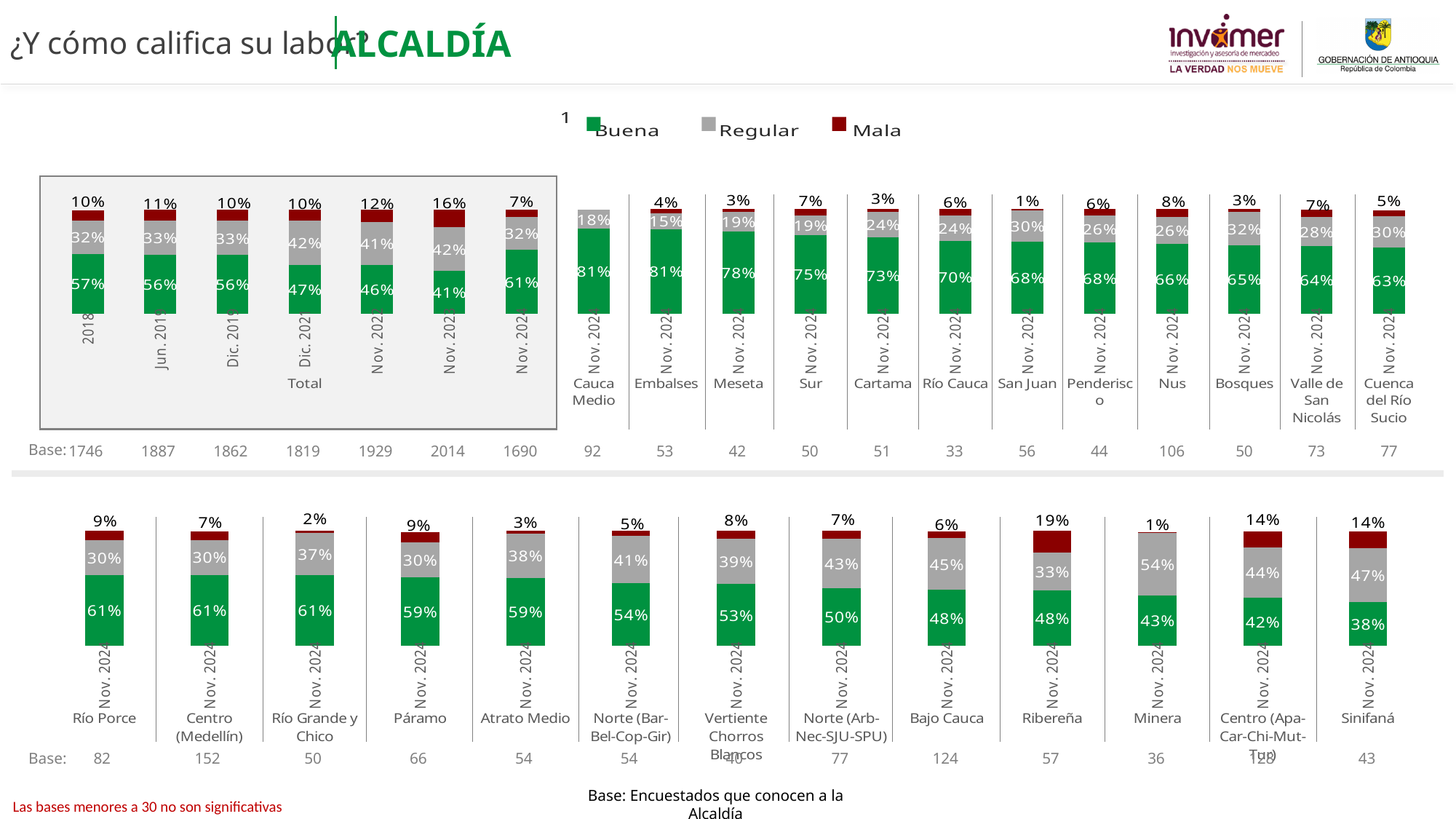
Among the regions in the top row, which has the highest Mala percentage? Nus What is the difference between the Buena percentage for Embalses and for Cuenca del Río Sucio? 18% How many series does the legend list? 3 What is the Mala percentage for Ribereña? 19% How many time periods are shown in the Total chart? 7 What is the base (number of respondents) for Nus? 106 What percentage of respondents in Cauca Medio rated the Alcaldía as Buena? 81% What is the Regular percentage for Minera? 54% Among the regions in the bottom row, which has the lowest Buena percentage? Sinifaná Which has a higher Buena percentage, Meseta or Sur? Meseta What type of chart is used on this slide? Stacked bar chart In the Total chart, what percentage rated the Alcaldía as Buena in 2018? 57%